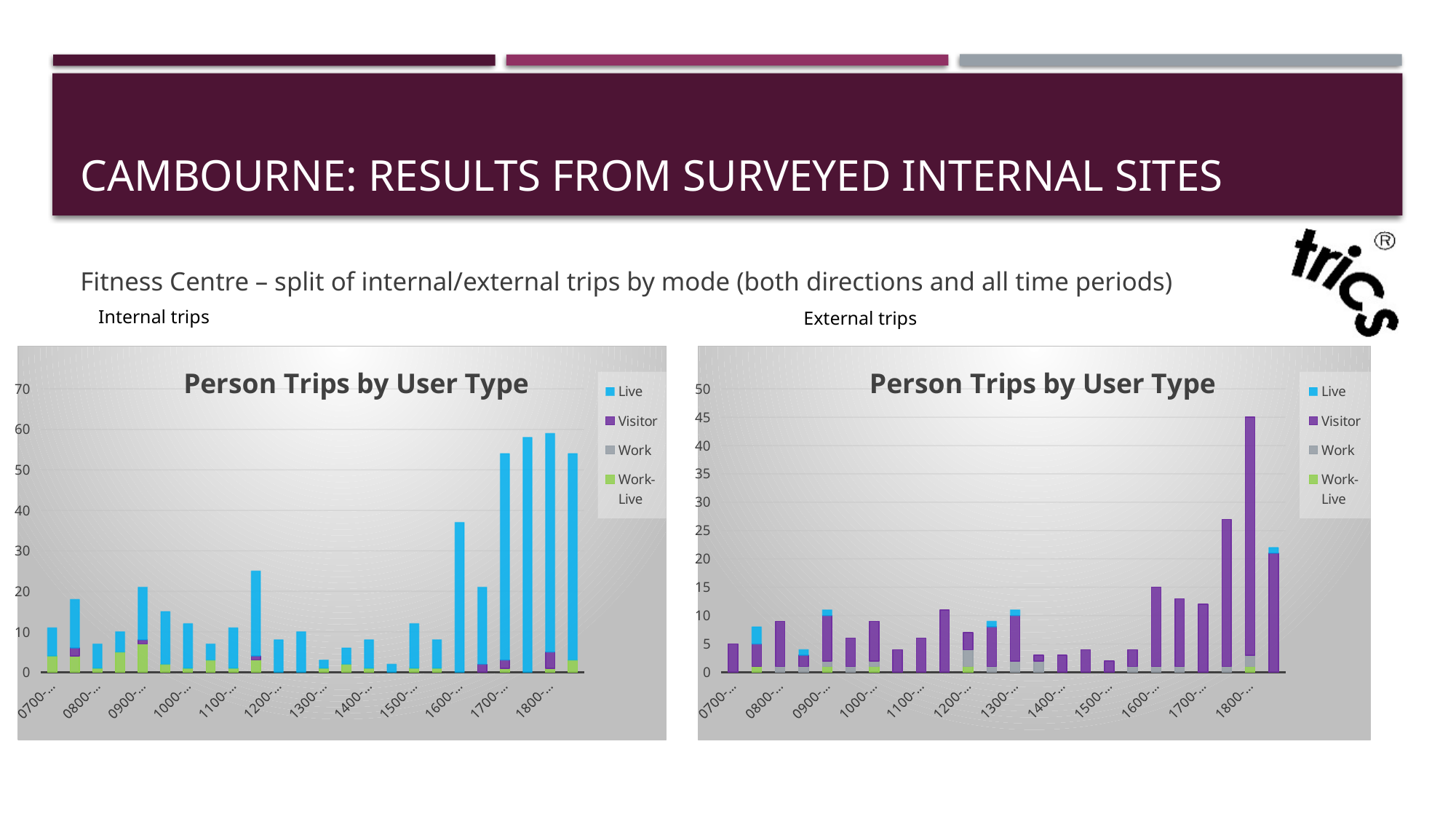
In the External trips chart, is the tallest bar greater or less than 40? greater In the Internal trips chart, is the first bar under the 1600-... label greater or less than 30? greater In the Internal trips chart, which colour represents the Live series? blue In the External trips chart, which series makes up most of the bar height across the chart? Visitor What type of chart is the Internal trips chart? bar chart In the External trips chart, under which x-axis label does the tallest bar appear? 1800-... Which chart has the taller tallest bar, the Internal trips chart or the External trips chart? Internal trips chart What is the title of the Internal trips chart? Person Trips by User Type In the Internal trips chart, is the tallest bar greater or less than 50? greater In the Internal trips chart, under which x-axis label does the tallest bar appear? 1800-... How many series does the legend of the External trips chart list? 4 How many time-period labels are shown on the x axis of the External trips chart? 12